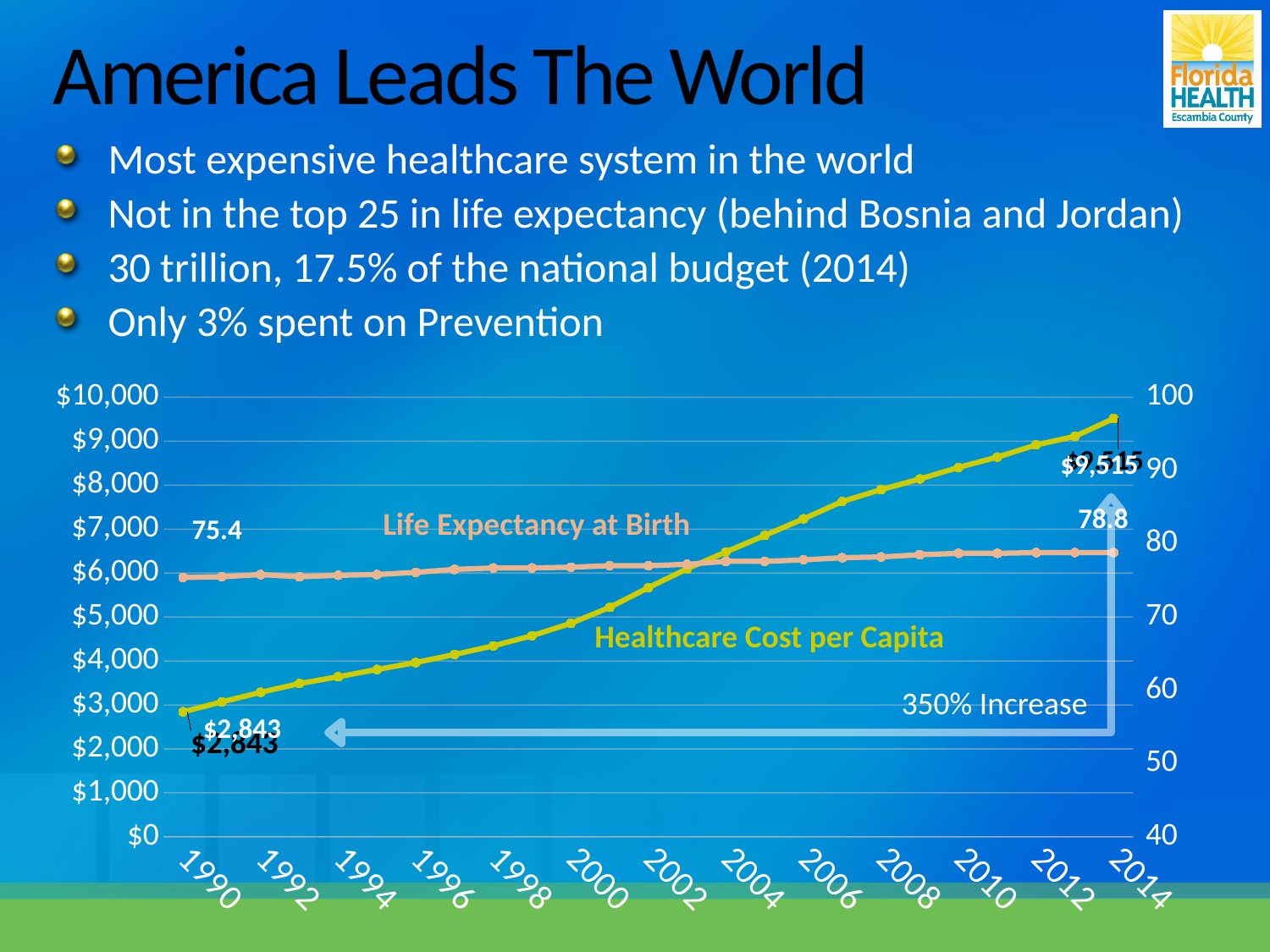
What was the Healthcare Cost per Capita in 1990? $2,843 In which year is the Healthcare Cost per Capita highest? 2014 By how much did Life Expectancy at Birth increase from 1990 to 2014? 3.4 What was the Life Expectancy at Birth in 2014? 78.8 What kind of chart is shown on the slide? line chart What was the Life Expectancy at Birth in 1990? 75.4 What percentage increase is annotated on the chart? 350% Increase By how much did the Healthcare Cost per Capita increase from 1990 to 2014? $6,672 How many year labels are shown on the x axis of the chart? 13 Does the Healthcare Cost per Capita rise or fall from 1990 to 2014? rise Is the Healthcare Cost per Capita in 2010 greater or less than $8,000? greater What was the Healthcare Cost per Capita in 2014? $9,515